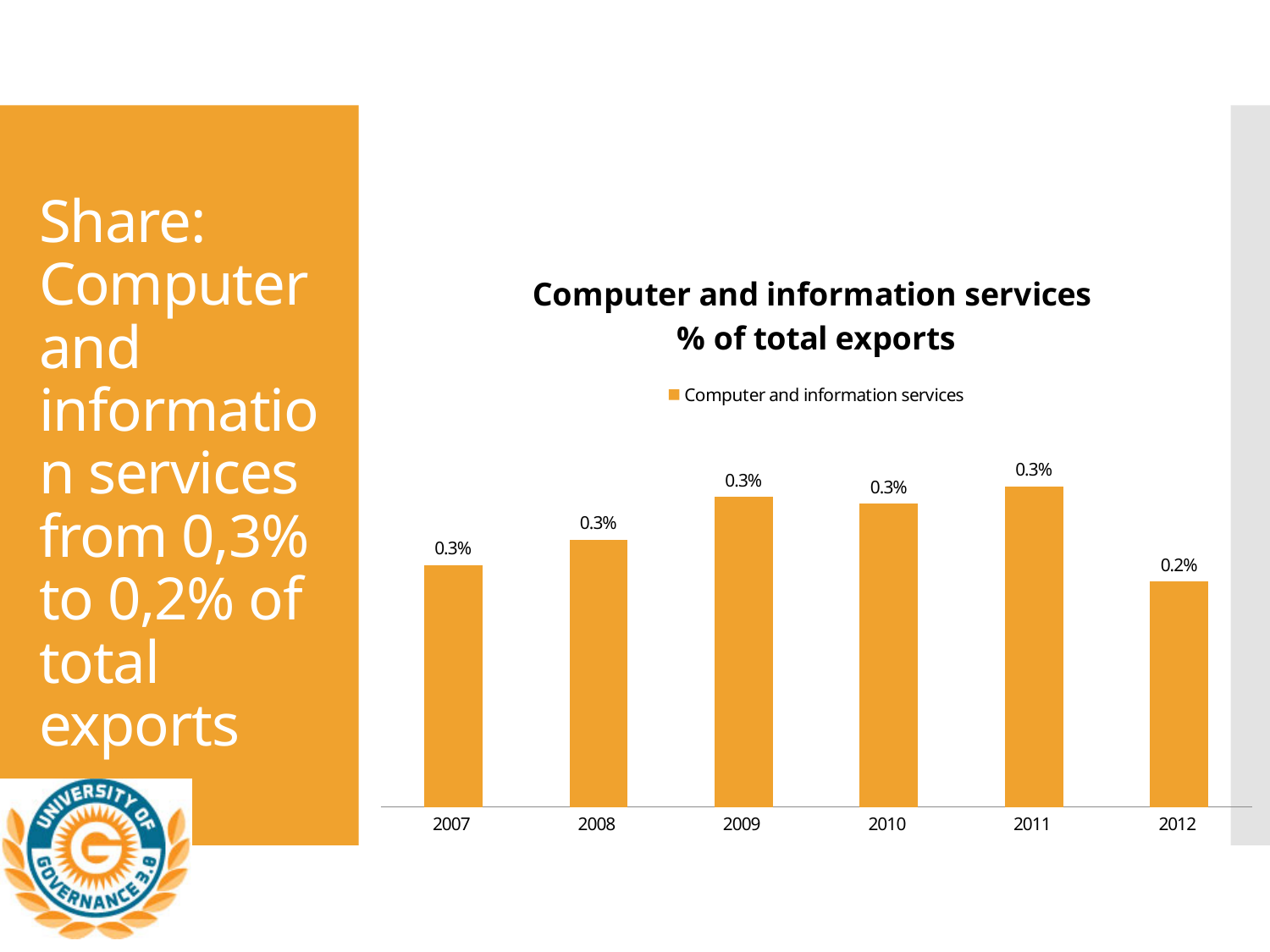
How many years are shown on the x axis of the chart? 6 What is the difference between the value for 2011 and the value for 2012? 0.1% What is the value for 2012 in the chart? 0.2% Does the value rise or fall from 2011 to 2012? fall How many series does the legend list? 1 What type of chart is shown on the slide? bar chart Which is larger, the value for 2009 or the value for 2012? 2009 What is the title of the chart? Computer and information services % of total exports Which year has the lowest value in the chart? 2012 What is the value for 2007 in the chart? 0.3% What series name is shown in the chart legend? Computer and information services What is the value for 2010 in the chart? 0.3%